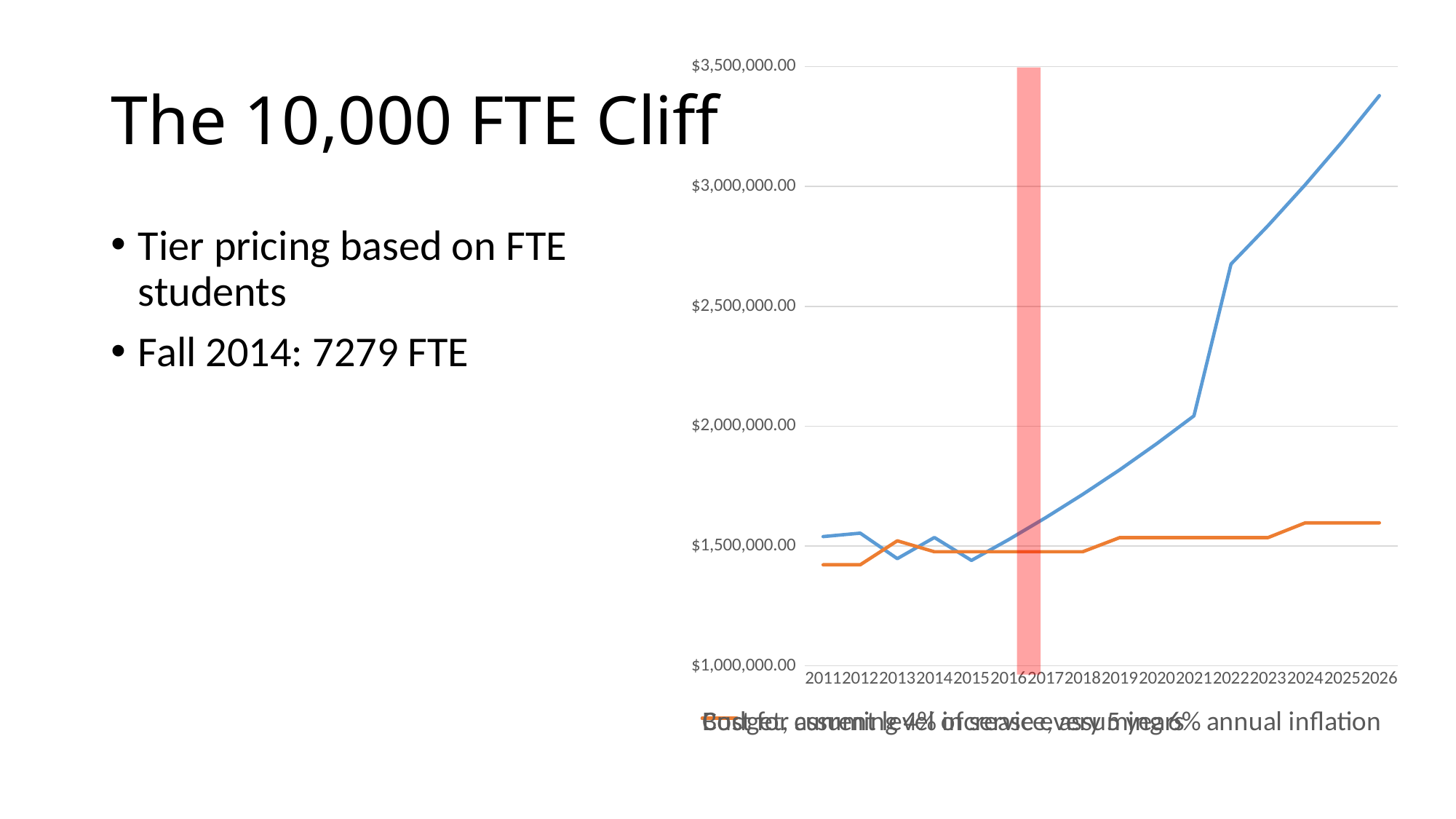
Is the value of the orange line in 2011 greater or less than $1,500,000.00? less In 2026, which line has the higher value, the blue line or the orange line? the blue line Is the value of the blue line in 2022 greater or less than $2,500,000.00? greater Does the blue line rise or fall from 2017 to 2026? rise Is the value of the blue line in 2011 greater or less than $2,000,000.00? less How many years are shown along the x axis of the chart? 16 What kind of chart is shown on the slide? line chart In which year does the blue line reach its highest value? 2026 What is the highest value labelled on the y axis of the chart? $3,500,000.00 How many lines are plotted on the chart? 2